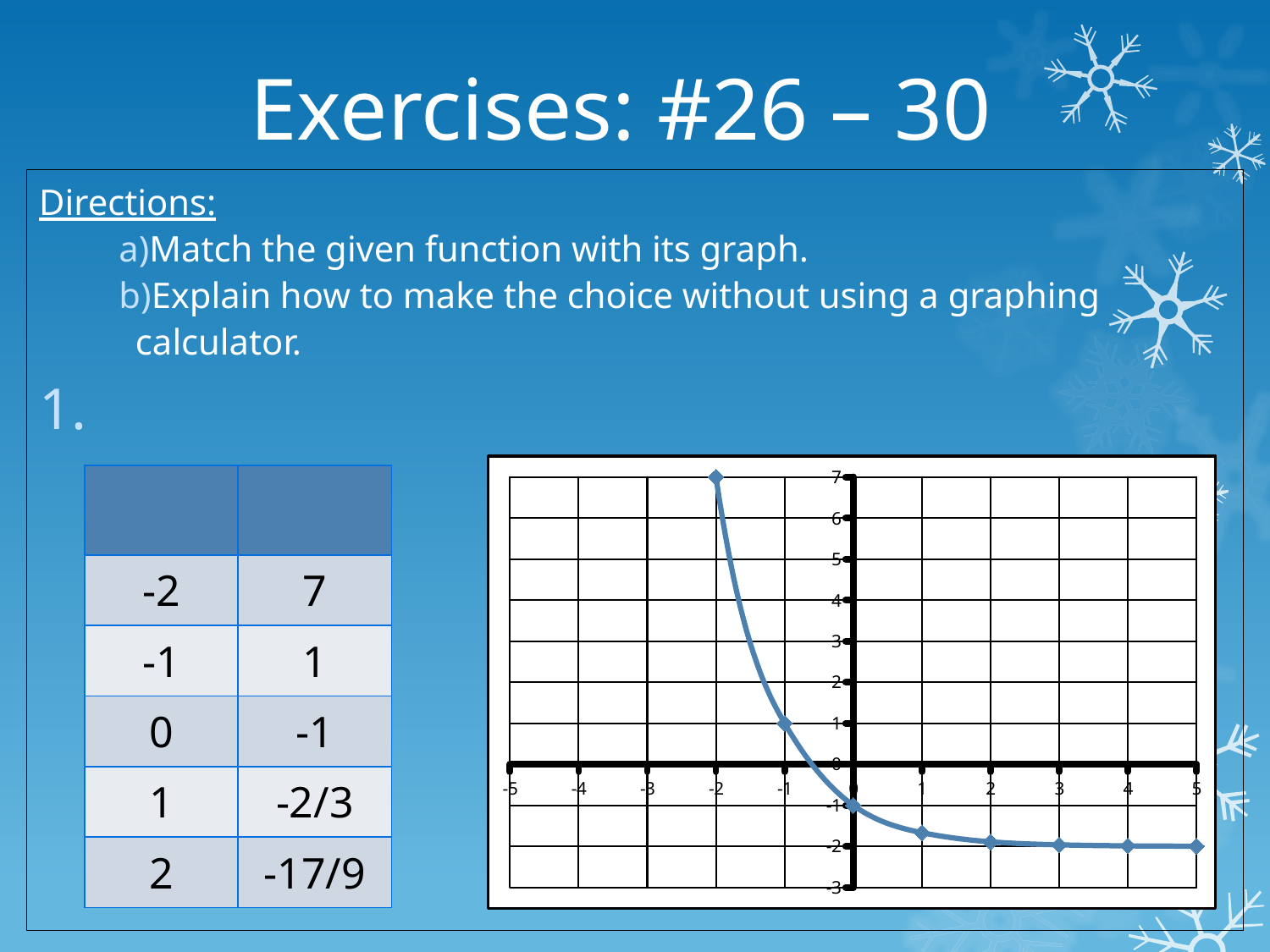
What is the difference between the y-values at x = -2 and x = -1? 6 What is the y-value of the plotted point at x = -1? 1 How many data points are plotted on the chart? 8 Is the y-value of the point at x = 1 greater or less than -1? less What is the y-value of the plotted point at x = -2? 7 At which x-value is the plotted point highest? -2 Which plotted point has the larger y-value, the one at x = -2 or the one at x = -1? x = -2 Is the y-value of the point at x = 5 greater or less than -3? greater Do the plotted values rise or fall as x increases? fall What is the y-value of the plotted point at x = 0? -1 What kind of chart is shown on the slide? line chart What is the highest value labelled on the y-axis of the chart? 7